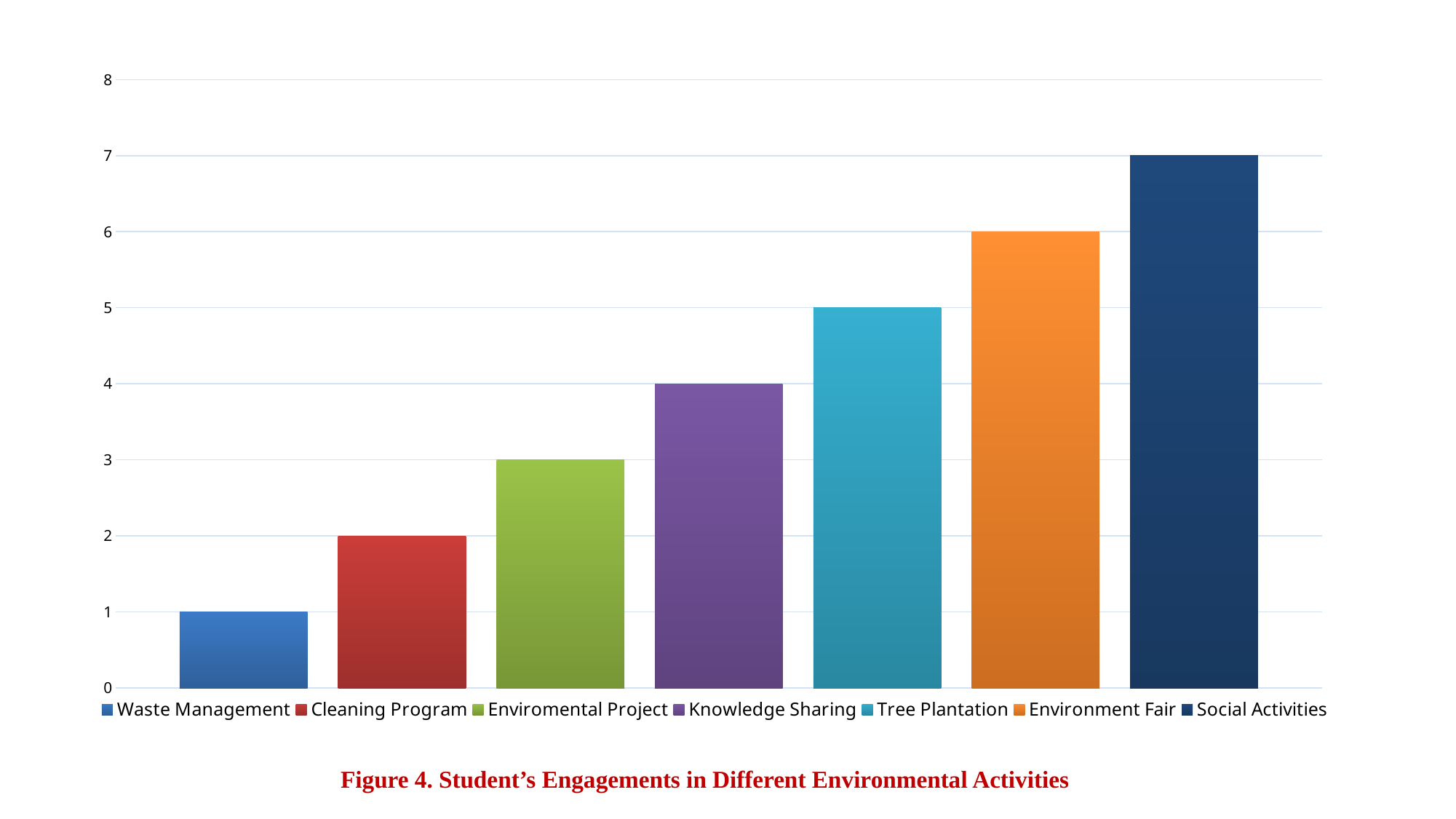
What kind of chart is shown on the slide? Bar chart What is the figure caption shown below the chart? Figure 4. Student's Engagements in Different Environmental Activities How many entries does the legend list? 7 Do the bar values rise or fall from left to right across the chart? Rise What is the value for Social Activities? 7 Which is larger, the value for Enviromental Project or the value for Tree Plantation? Tree Plantation What is the value for Tree Plantation? 5 What is the value for Cleaning Program? 2 Which activity has the highest bar? Social Activities How many bars are plotted in the chart? 7 What is the difference between the values for Environment Fair and Knowledge Sharing? 2 Which activity has the lowest bar? Waste Management